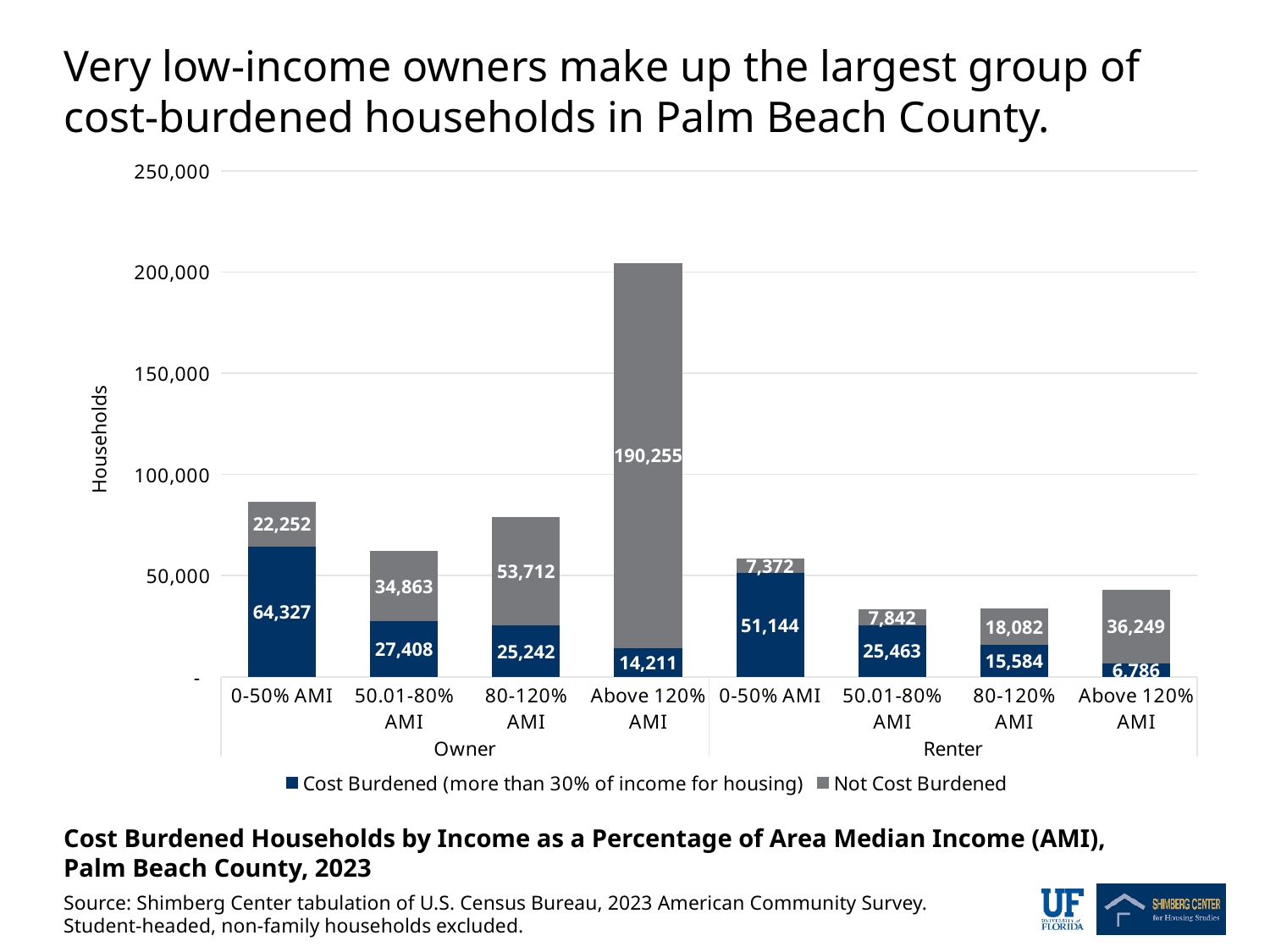
What is the total number of owner households in the 0-50% AMI category? 86,579 Is the total number of owner households in the 0-50% AMI category greater or less than 100,000? less How many income categories are plotted along the x axis? 8 What is the number of not cost-burdened owner households in the Above 120% AMI category? 190,255 What is the difference between cost-burdened owner households and cost-burdened renter households in the 0-50% AMI category? 13,183 Which category has the highest number of cost-burdened households? Owner, 0-50% AMI Which category has the lowest number of cost-burdened households? Renter, Above 120% AMI How many series does the legend list? 2 Which is larger: the number of not cost-burdened renter households in the 80-120% AMI category or the number of cost-burdened renter households in that category? Not cost burdened (18,082) What type of chart is shown on the slide? Stacked bar chart What is the number of cost-burdened renter households in the 50.01-80% AMI category? 25,463 What is the number of cost-burdened owner households in the 0-50% AMI category? 64,327